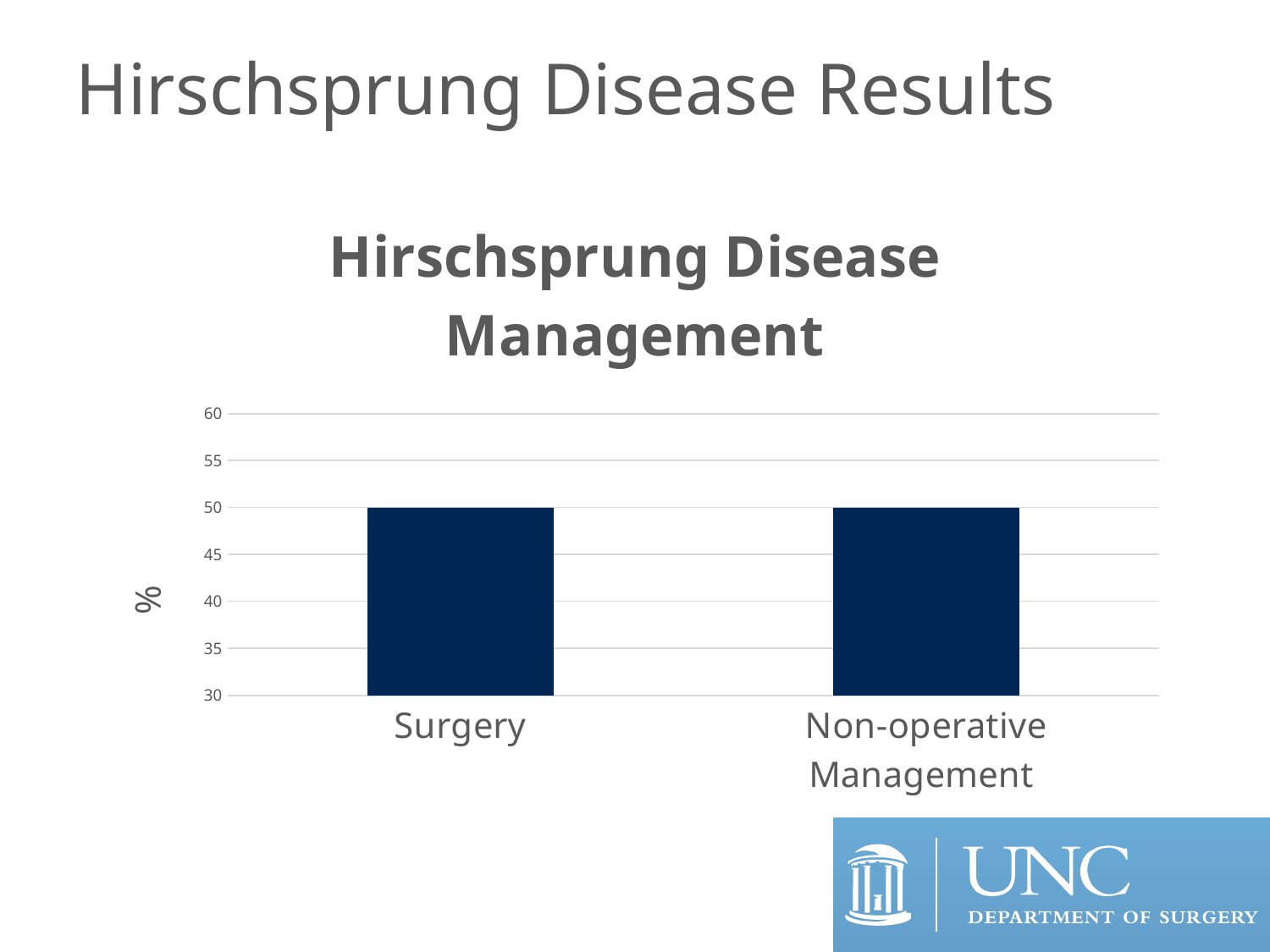
What kind of chart is shown on the slide? bar chart What is the value for Non-operative Management? 50 Is the value for Non-operative Management greater or less than 35? greater What is the title of the chart? Hirschsprung Disease Management Is the value for Non-operative Management greater or less than 60? less What is the difference between the values for Surgery and Non-operative Management? 0 Is the value for Surgery greater or less than 40? greater What is the label on the vertical axis? % What is the lowest value shown on the vertical axis? 30 How many categories are shown on the x axis? 2 What is the value for Surgery? 50